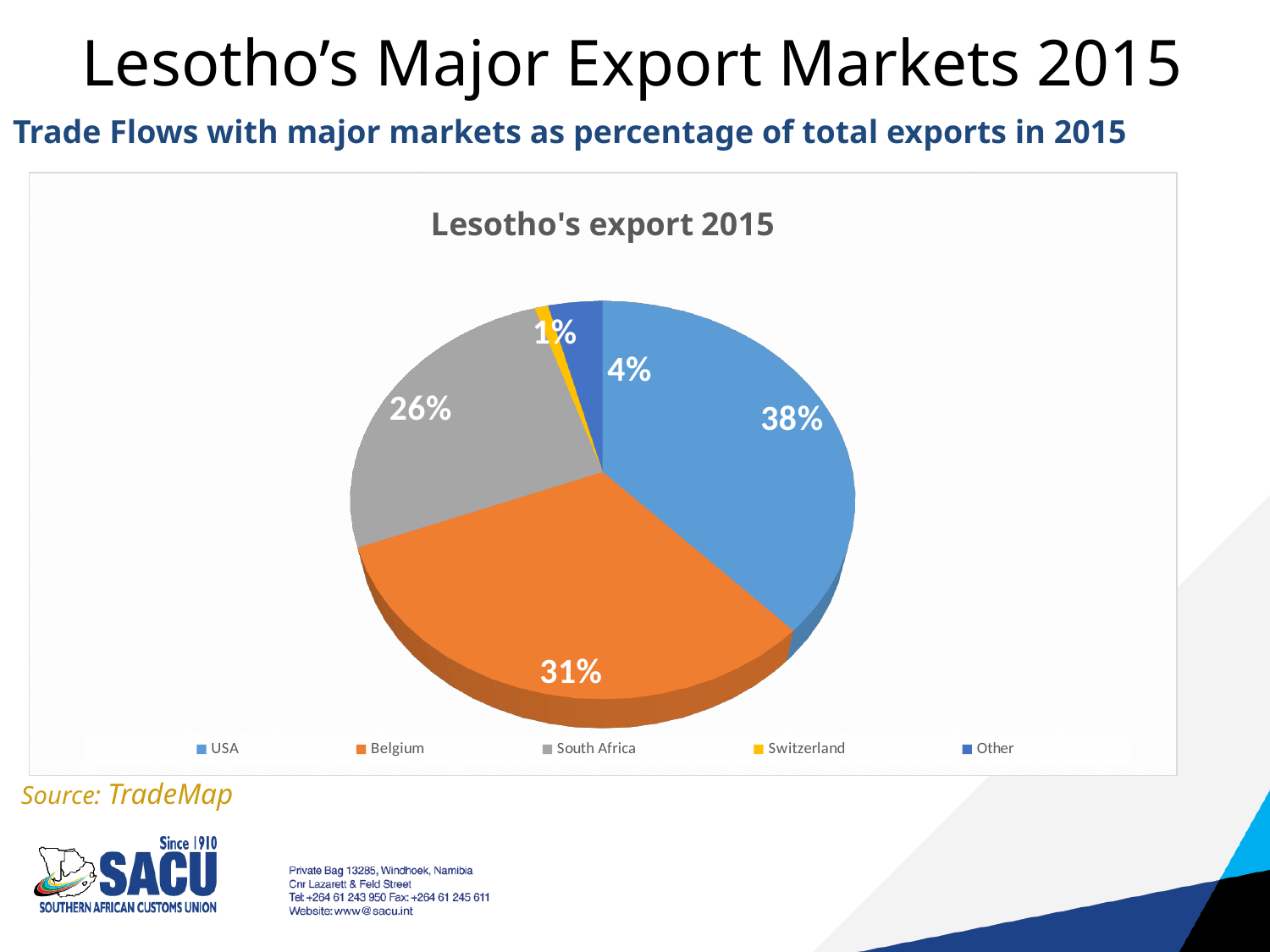
What is the difference in percentage points between the USA's share and Belgium's share? 7 What share of Lesotho's exports in 2015 is labelled Other? 4% What share of Lesotho's exports in 2015 went to Belgium? 31% Which export market has the smallest share of Lesotho's exports in 2015? Switzerland Which export market has the largest share of Lesotho's exports in 2015? USA How many categories does the pie chart show? 5 What share of Lesotho's exports in 2015 went to the USA? 38% Which has a larger share of Lesotho's 2015 exports, Belgium or South Africa? Belgium What share of Lesotho's exports in 2015 went to South Africa? 26% What share of Lesotho's exports in 2015 went to Switzerland? 1% What is the title of the chart? Lesotho's export 2015 What kind of chart is shown on the slide? Pie chart